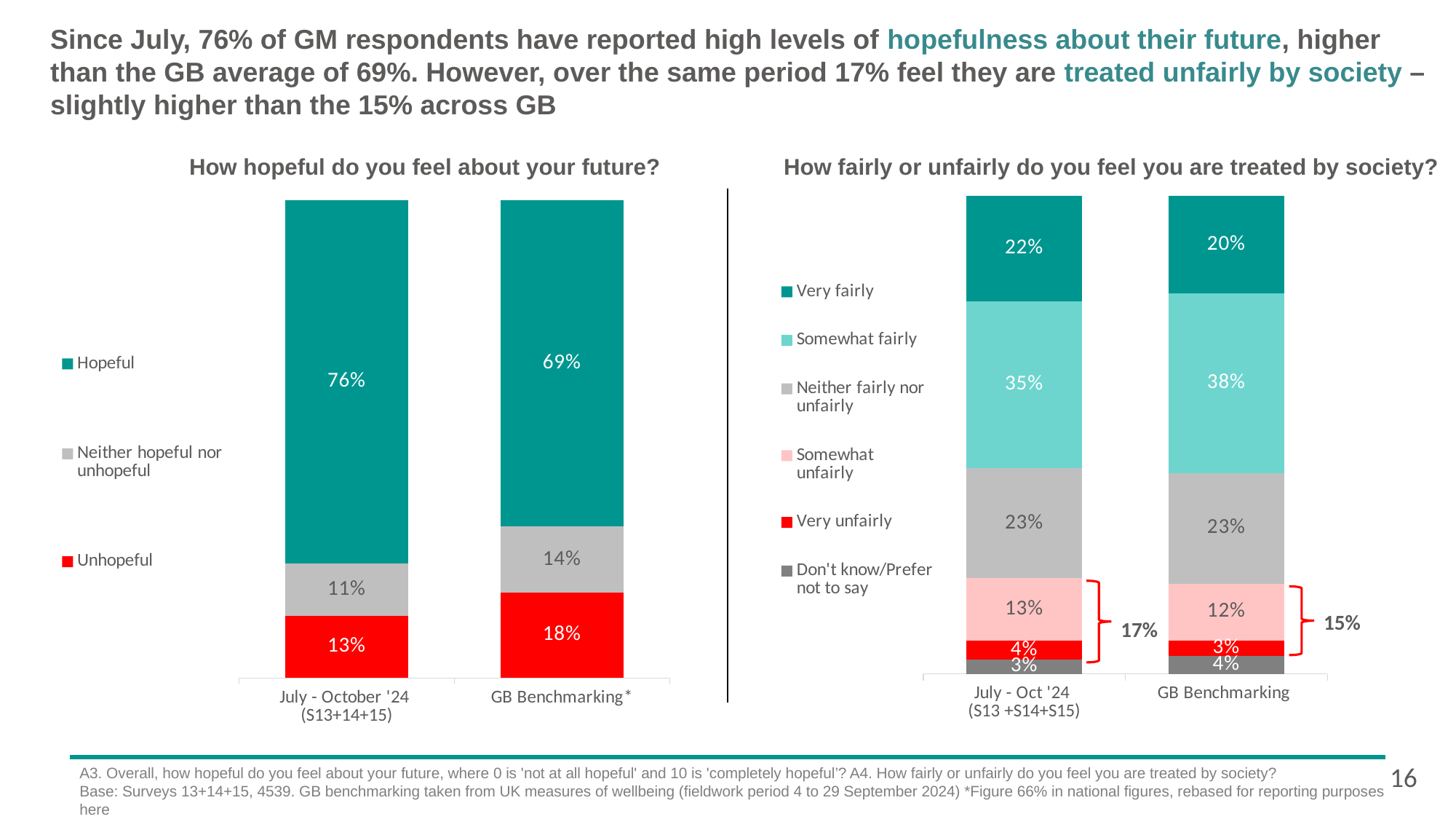
In the chart 'How fairly or unfairly do you feel you are treated by society?', what is the combined total of Somewhat unfairly and Very unfairly for July - Oct '24? 17% In the chart 'How hopeful do you feel about your future?', which bar has the larger 'Neither hopeful nor unhopeful' value, July - October '24 or GB Benchmarking? GB Benchmarking In the chart 'How hopeful do you feel about your future?', what is the difference between the Hopeful values for July - October '24 and GB Benchmarking? 7 percentage points In the chart 'How fairly or unfairly do you feel you are treated by society?', which segment is the smallest in the GB Benchmarking bar? Very unfairly In the chart 'How fairly or unfairly do you feel you are treated by society?', how many series does the legend list? 6 In the chart 'How fairly or unfairly do you feel you are treated by society?', what is the Somewhat fairly value for GB Benchmarking? 38% In the chart 'How fairly or unfairly do you feel you are treated by society?', which segment is the largest in the July - Oct '24 bar? Somewhat fairly In the chart 'How hopeful do you feel about your future?', how many series does the legend list? 3 In the chart 'How hopeful do you feel about your future?', what is the Unhopeful value for GB Benchmarking? 18% In the chart 'How hopeful do you feel about your future?', what percentage of July - October '24 respondents are Hopeful? 76% What type of chart is 'How hopeful do you feel about your future?' Stacked bar chart In the chart 'How fairly or unfairly do you feel you are treated by society?', what is the Very unfairly value for July - Oct '24? 4%